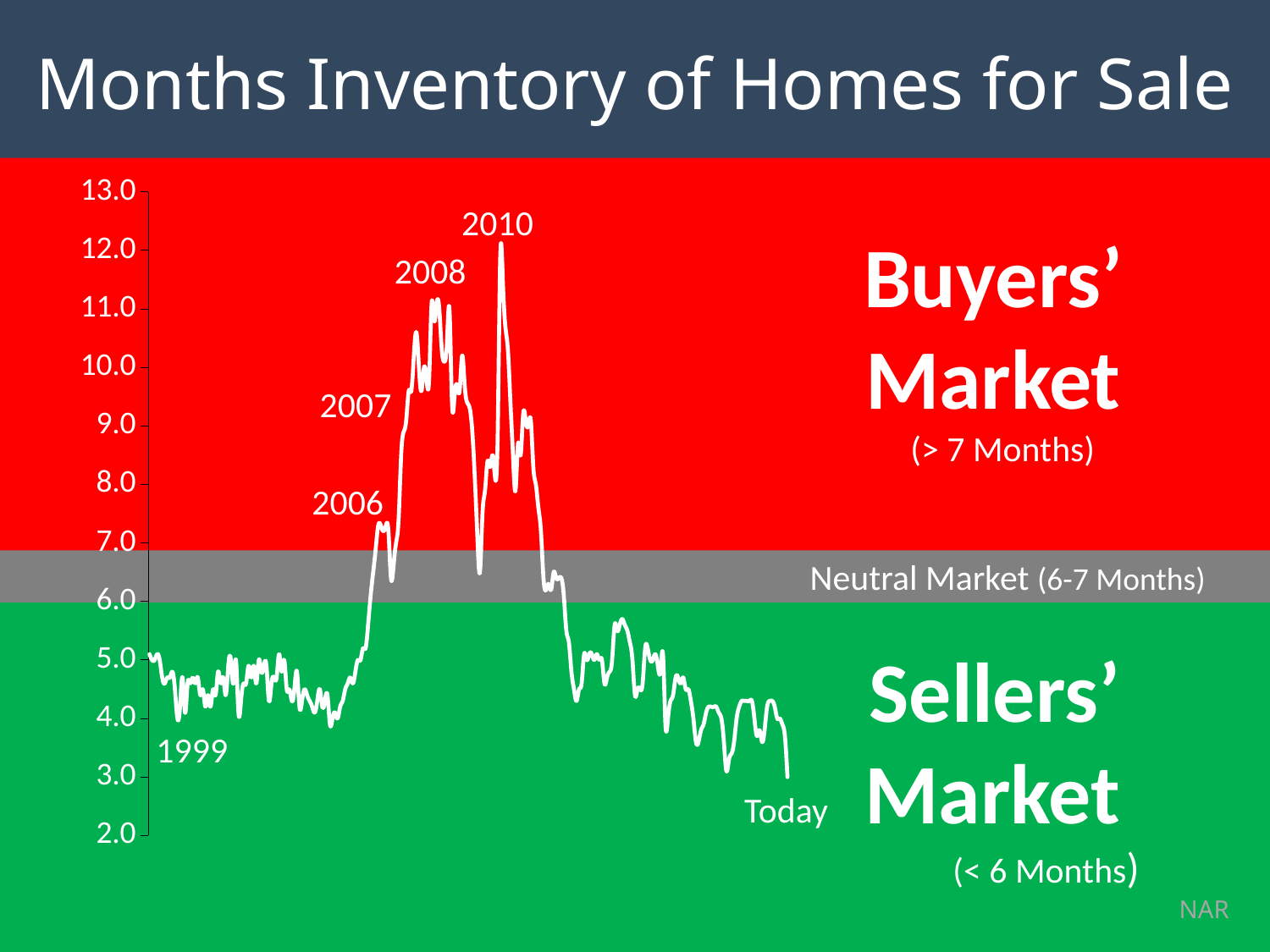
Is the value at the point labelled Today greater or less than 4.0? less Which labelled year marks the highest peak of the line? 2010 Which is larger, the value at 1999 or the value at Today? 1999 Is the value at the point labelled 1999 greater or less than 6.0? less Does the line rise or fall from the 2010 peak to the point labelled Today? fall Which peak is higher, the one labelled 2010 or the one labelled 2008? 2010 According to the slide, how many months of inventory define a Neutral Market? 6-7 Months What kind of chart is shown on the slide? line chart Is the peak value at 2010 greater or less than 11.0? greater What is the highest value shown on the y axis? 13.0 What is the title of the chart? Months Inventory of Homes for Sale